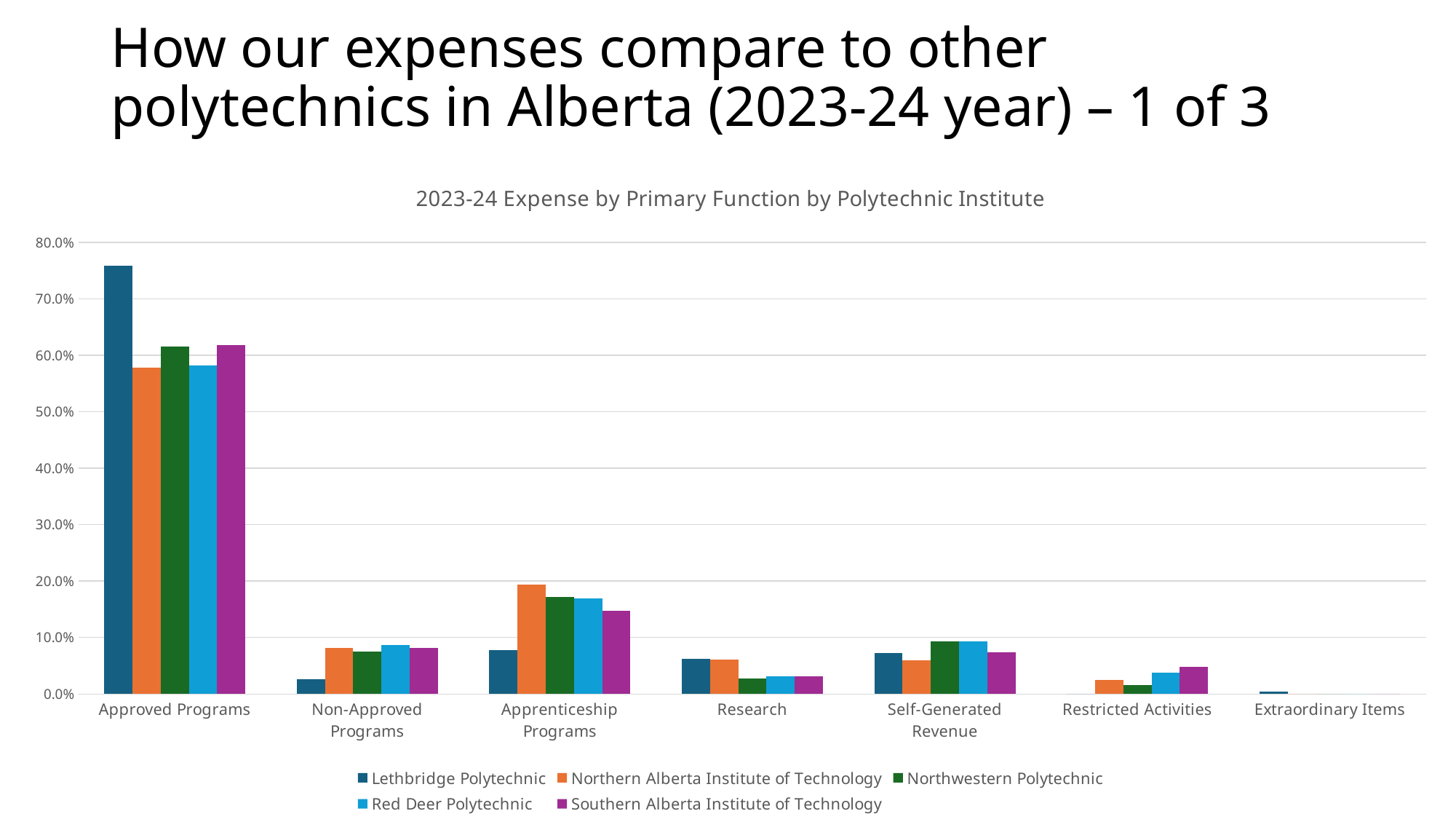
Which institution has the lowest share of expenses in Non-Approved Programs? Lethbridge Polytechnic Which institution has the highest share of expenses in Approved Programs? Lethbridge Polytechnic Is the value for Northern Alberta Institute of Technology in Apprenticeship Programs greater or less than 10.0%? greater In Non-Approved Programs, which is larger: Lethbridge Polytechnic or Northern Alberta Institute of Technology? Northern Alberta Institute of Technology How many expense categories are shown along the x axis of the chart? 7 Is the value for Lethbridge Polytechnic in Approved Programs greater or less than 70.0%? greater In Apprenticeship Programs, which is larger: Lethbridge Polytechnic or Southern Alberta Institute of Technology? Southern Alberta Institute of Technology Is the value for Lethbridge Polytechnic in Apprenticeship Programs greater or less than 10.0%? less What is the title of the chart? 2023-24 Expense by Primary Function by Polytechnic Institute What kind of chart is shown on the slide? Bar chart Which institution has the highest share of expenses in Apprenticeship Programs? Northern Alberta Institute of Technology How many institutions does the chart's legend list? 5